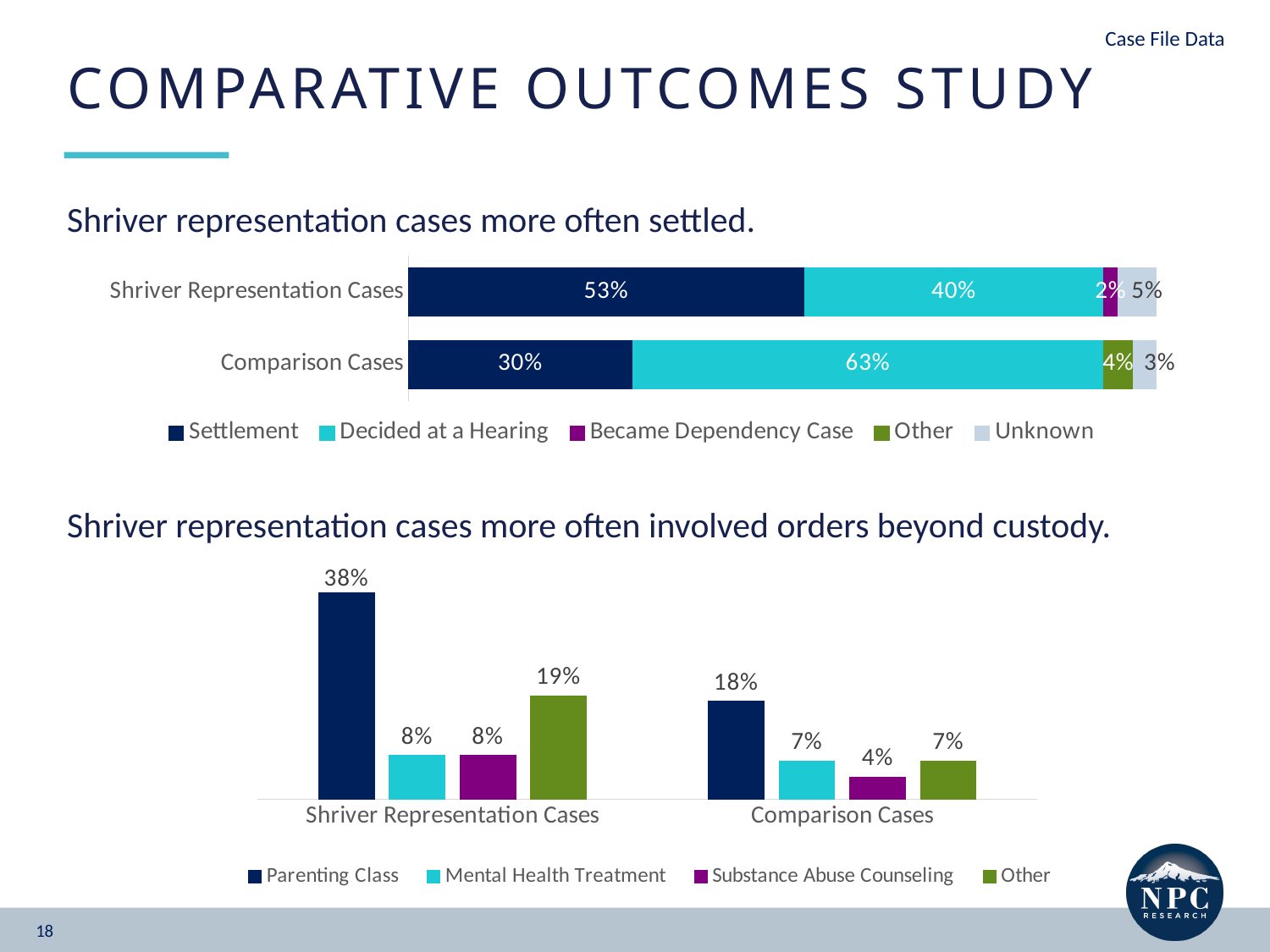
In the top chart, what percentage of Comparison Cases were Decided at a Hearing? 63% In the top chart, which group has the larger Decided at a Hearing share, Shriver Representation Cases or Comparison Cases? Comparison Cases What kind of chart is the top chart? Stacked bar chart In the bottom chart, what percentage of Shriver Representation Cases involved a Parenting Class order? 38% In the top chart, what percentage of Shriver Representation Cases ended in Settlement? 53% In the bottom chart, what percentage of Comparison Cases involved Substance Abuse Counseling? 4% How many series does the legend of the top chart list? 5 In the top chart, what is the difference between the Settlement share for Shriver Representation Cases and for Comparison Cases? 23 percentage points How many series does the legend of the bottom chart list? 4 In the bottom chart, which order type has the highest value for Comparison Cases? Parenting Class In the bottom chart, what is the difference between the Other value for Shriver Representation Cases and for Comparison Cases? 12 percentage points In the bottom chart, which order type has the lowest value for Comparison Cases? Substance Abuse Counseling